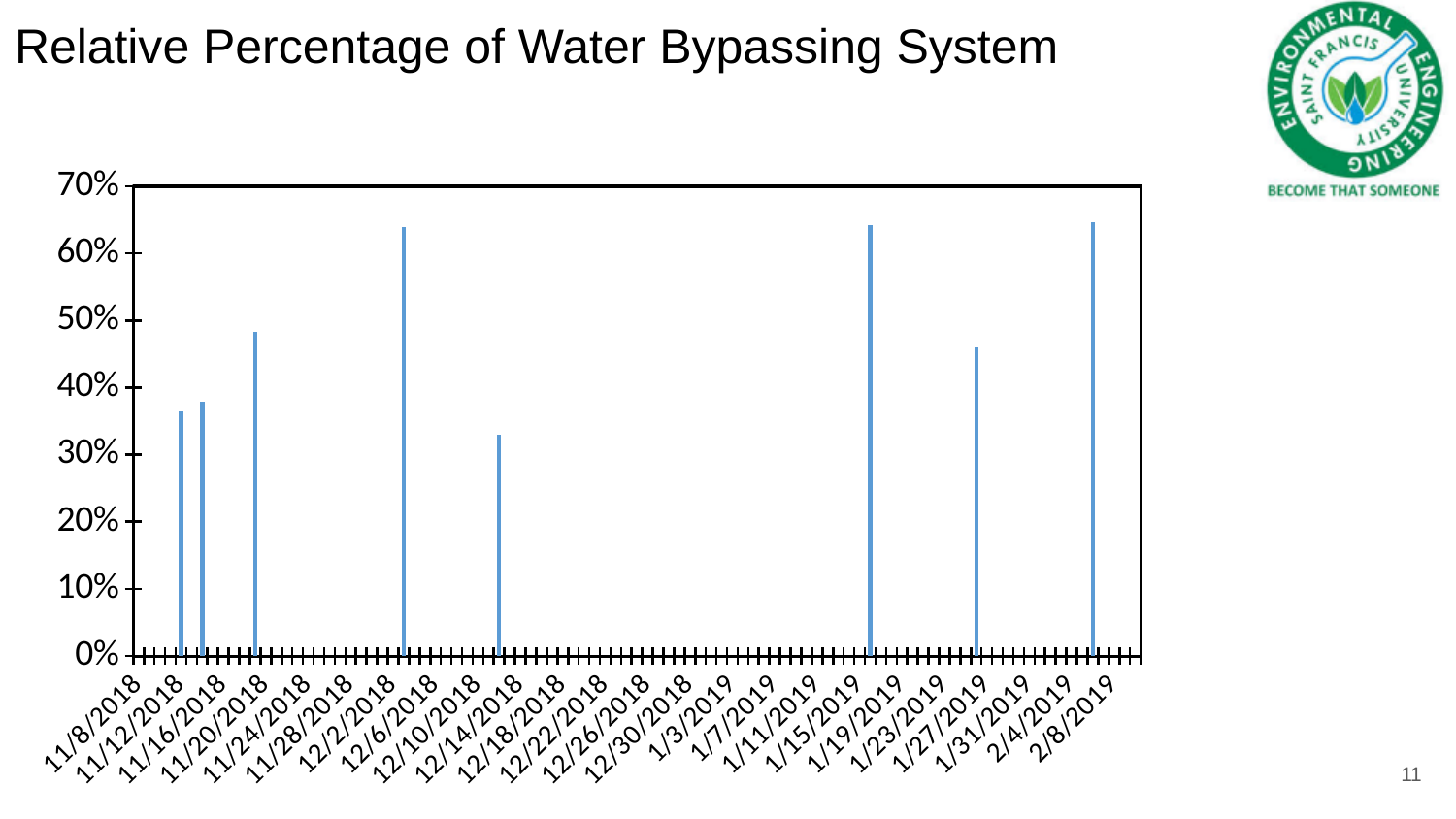
Which is larger: the bar at 12/14/2018 or the bar between 1/15/2019 and 1/19/2019? the bar between 1/15/2019 and 1/19/2019 Is the value of the first bar (at 11/12/2018) greater or less than 40%? less What is the title of the slide's chart? Relative Percentage of Water Bypassing System What type of chart is shown on the slide? bar chart Is the value of the first bar (at 11/12/2018) greater or less than 30%? greater Is the value of the bar between 11/16/2018 and 11/20/2018 greater or less than 50%? less How many bars are plotted in the chart? 8 Which is larger: the first bar (at 11/12/2018) or the bar between 11/16/2018 and 11/20/2018? the bar between 11/16/2018 and 11/20/2018 What is the highest value shown on the y-axis? 70%